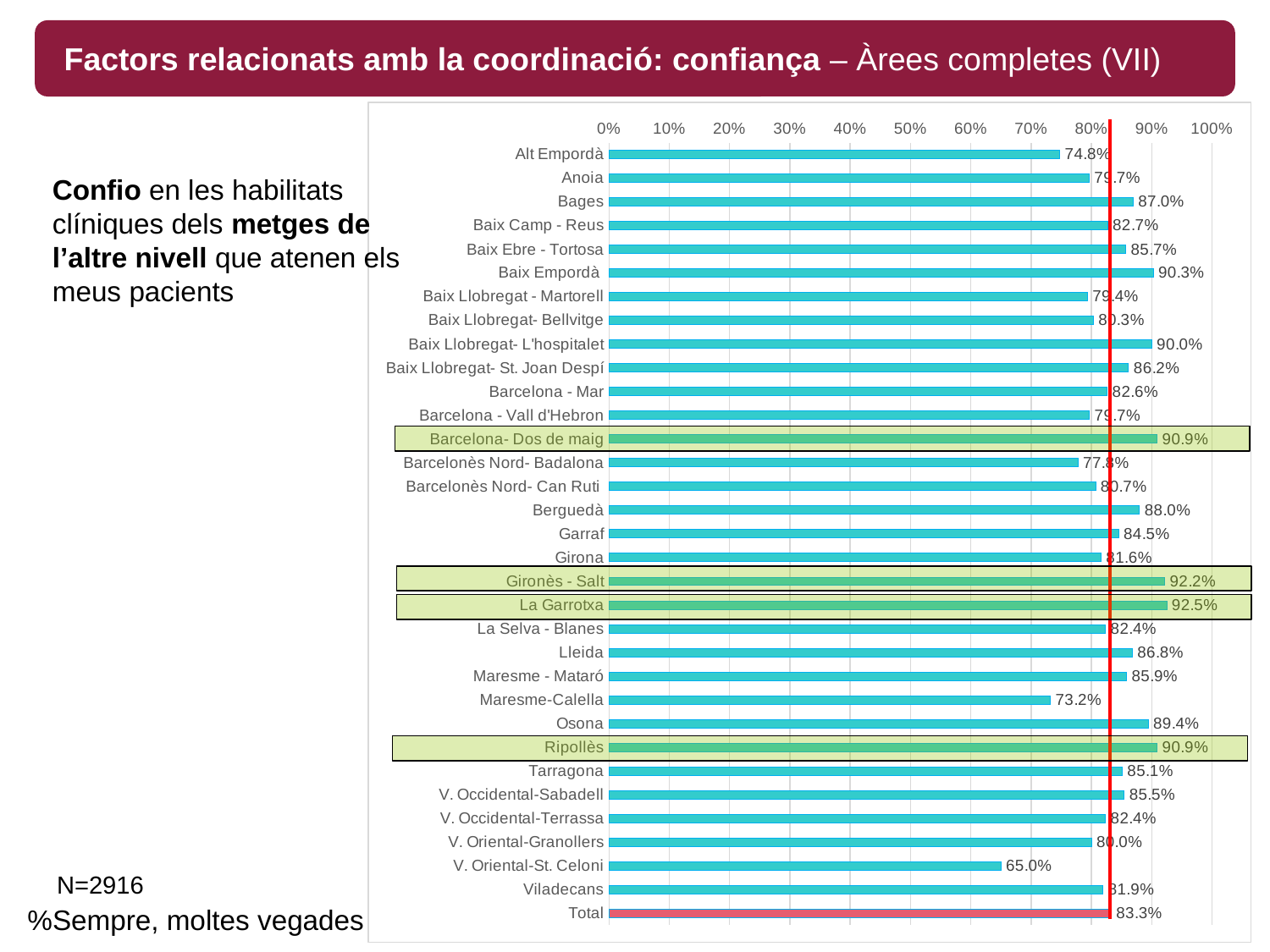
Which area has the highest value? La Garrotxa How many bars are shown in the chart, including Total? 33 What is the value for La Garrotxa? 92.5% What is the difference between the values for Bages and Alt Empordà? 12.2 percentage points What is the sample size (N) stated on the slide? N=2916 Is the value for V. Oriental-St. Celoni greater or less than 70%? less What is the value for Alt Empordà? 74.8% Which area has the lowest value? V. Oriental-St. Celoni What is the value for Maresme-Calella? 73.2% What is the value for the Total bar? 83.3% What kind of chart is shown on the slide? Horizontal bar chart Which is larger, the value for Osona or the value for Berguedà? Osona